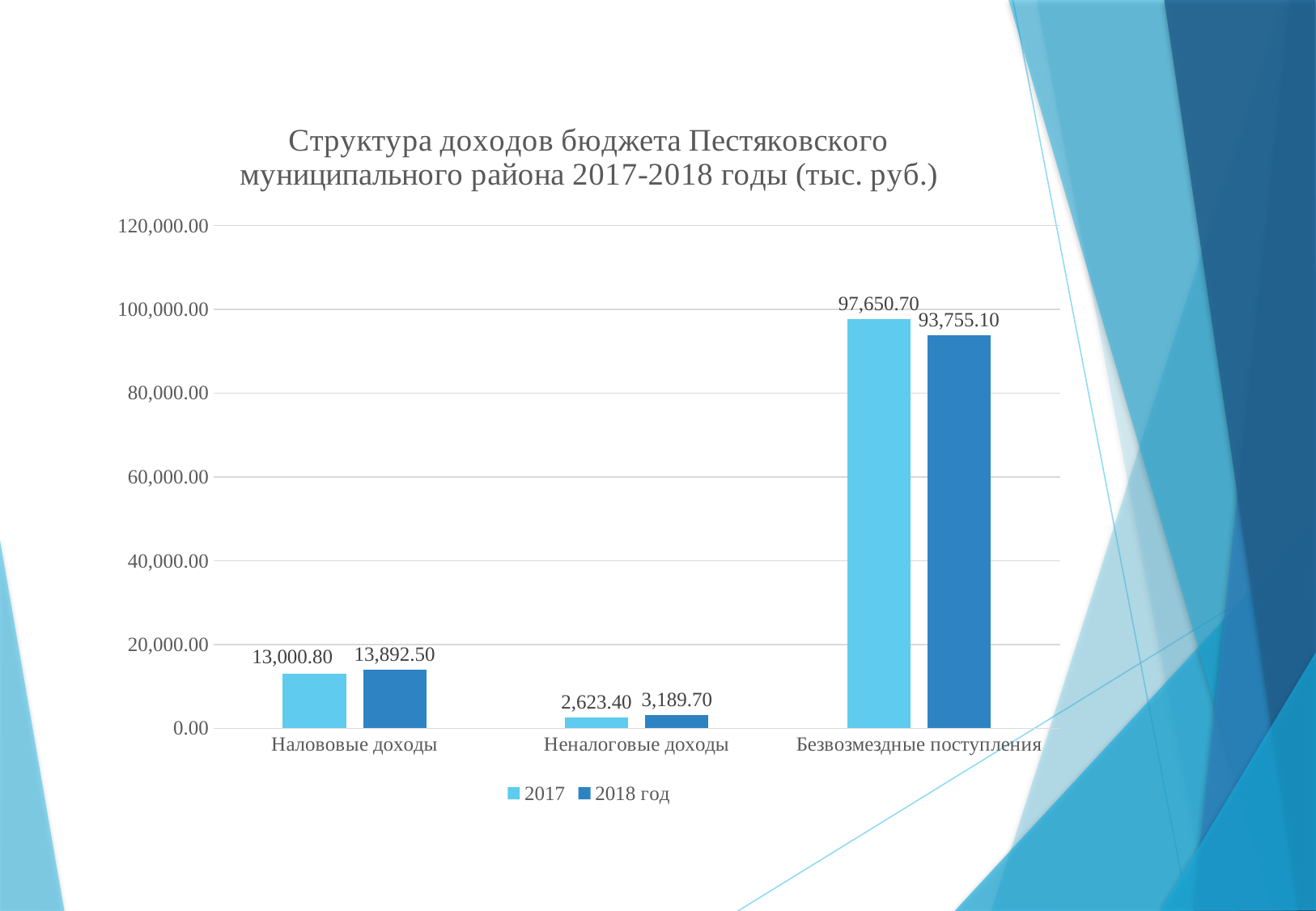
What is the difference between the 2018 год and 2017 values for Налововые доходы? 891.70 How many series does the legend list? 2 Which category has the highest value in the 2018 год series? Безвозмездные поступления Is the 2017 value for Безвозмездные поступления greater or less than 80,000.00? greater For Безвозмездные поступления, which series has the larger value, 2017 or 2018 год? 2017 What is the value for Неналоговые доходы in the 2017 series? 2,623.40 What is the value for Налововые доходы in the 2017 series? 13,000.80 What is the value for Безвозмездные поступления in the 2018 год series? 93,755.10 What kind of chart is shown on the slide? Bar chart Which category has the lowest value in the 2017 series? Неналоговые доходы How many categories are shown on the x axis? 3 What is the difference between the 2017 and 2018 год values for Безвозмездные поступления? 3,895.60